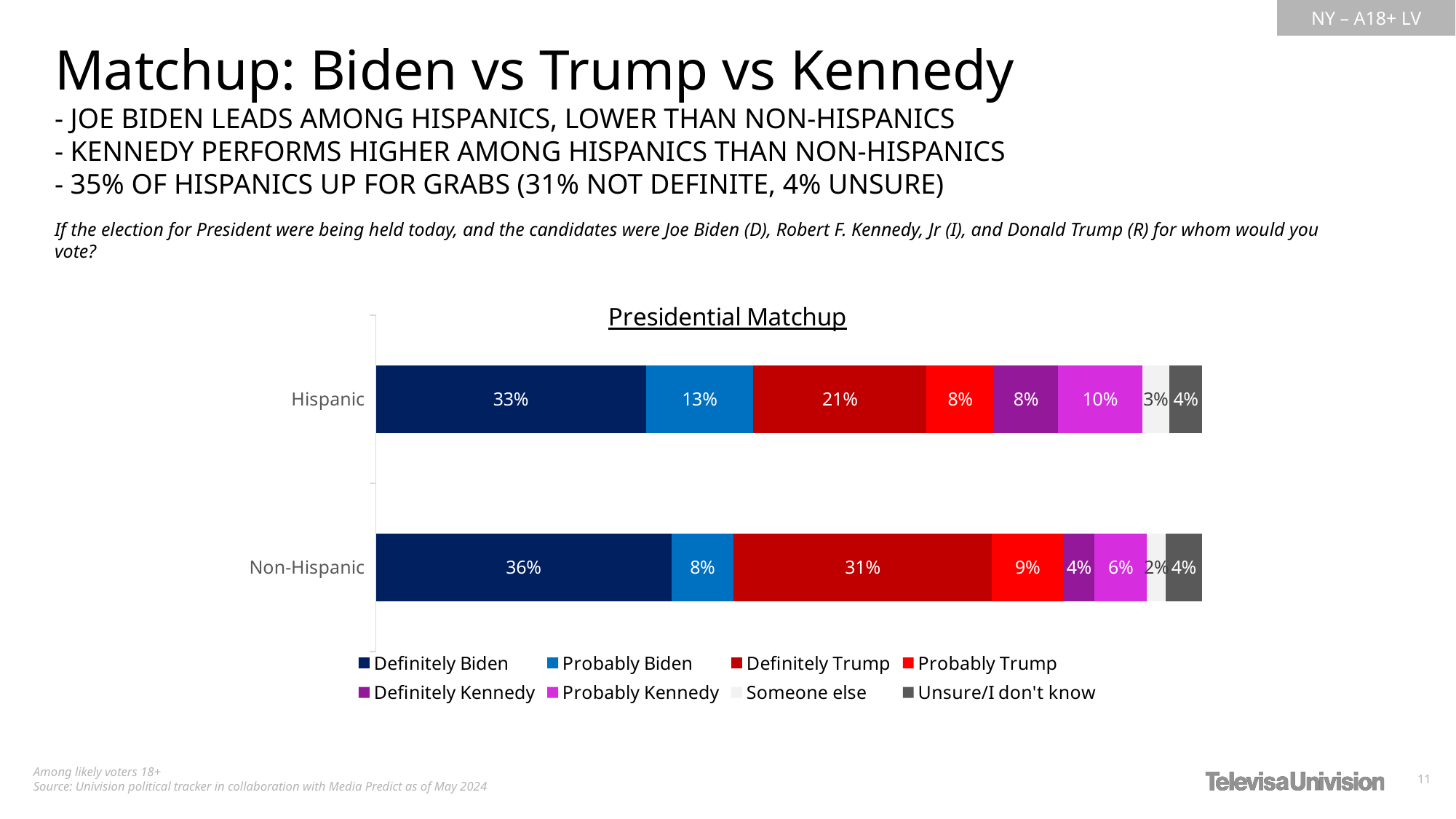
Which segment is the largest in the Hispanic bar? Definitely Biden What percentage of Non-Hispanic voters say Definitely Trump? 31% What is the difference between the Definitely Trump values for Non-Hispanic and Hispanic voters? 10% What kind of chart is the Presidential Matchup chart? Stacked bar chart What percentage of Hispanic voters say Definitely Biden? 33% What is the combined Definitely Kennedy and Probably Kennedy value for Hispanic voters? 18% How many categories (bars) does the Presidential Matchup chart show? 2 What is the Someone else value for Non-Hispanic voters? 2% How many series does the legend list? 8 Which group has a higher Probably Biden value, Hispanic or Non-Hispanic? Hispanic What is the Probably Kennedy value for Hispanic voters? 10% Which segment is the smallest in the Non-Hispanic bar? Someone else